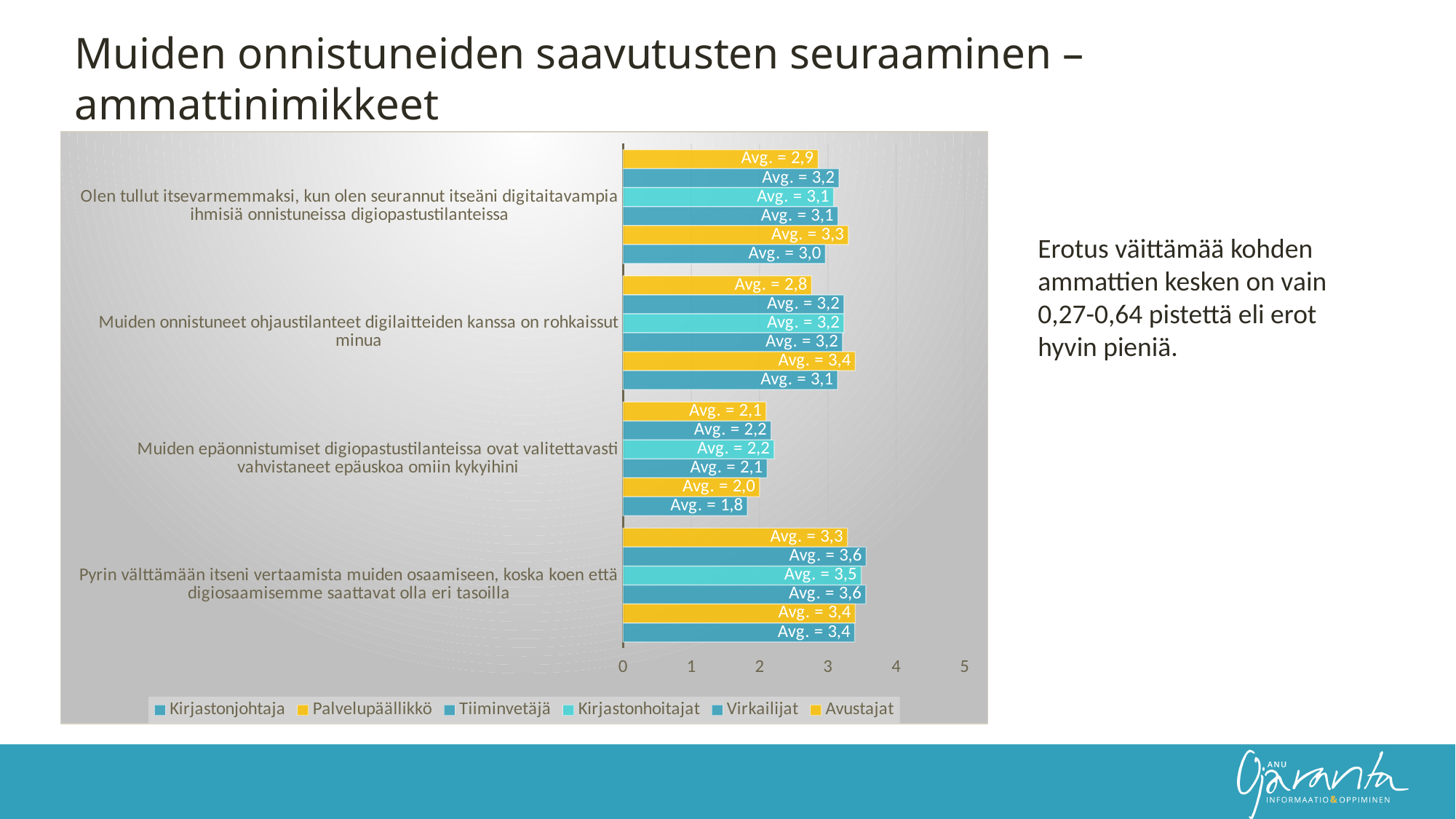
What is the value for Kirjastonhoitajat for the statement 'Muiden epäonnistumiset digiopastustilanteissa ovat valitettavasti vahvistaneet epäuskoa omiin kykyihini'? 2,2 What is the difference between the Kirjastonhoitajat values for 'Pyrin välttämään itseni vertaamista muiden osaamiseen...' and 'Muiden epäonnistumiset digiopastustilanteissa...'? 1,3 What is the highest value shown for the statement 'Muiden onnistuneet ohjaustilanteet digilaitteiden kanssa on rohkaissut minua'? 3,4 For Kirjastonhoitajat, which statement has the larger value: 'Olen tullut itsevarmemmaksi...' or 'Muiden onnistuneet ohjaustilanteet digilaitteiden kanssa on rohkaissut minua'? Muiden onnistuneet ohjaustilanteet digilaitteiden kanssa on rohkaissut minua What is the value for Kirjastonhoitajat for the statement 'Pyrin välttämään itseni vertaamista muiden osaamiseen, koska koen että digiosaamisemme saattavat olla eri tasoilla'? 3,5 Is the value for Kirjastonhoitajat for 'Muiden epäonnistumiset digiopastustilanteissa...' greater or less than 3? less What is the lowest value shown for the statement 'Olen tullut itsevarmemmaksi, kun olen seurannut itseäni digitaitavampia ihmisiä onnistuneissa digiopastustilanteissa'? 2,9 How many series does the chart legend list? 6 Which series is listed first in the chart legend? Kirjastonjohtaja What is the lowest value shown for the statement 'Muiden epäonnistumiset digiopastustilanteissa ovat valitettavasti vahvistaneet epäuskoa omiin kykyihini'? 1,8 What kind of chart is shown on the slide? Bar chart How many statements (categories) are plotted on the chart? 4